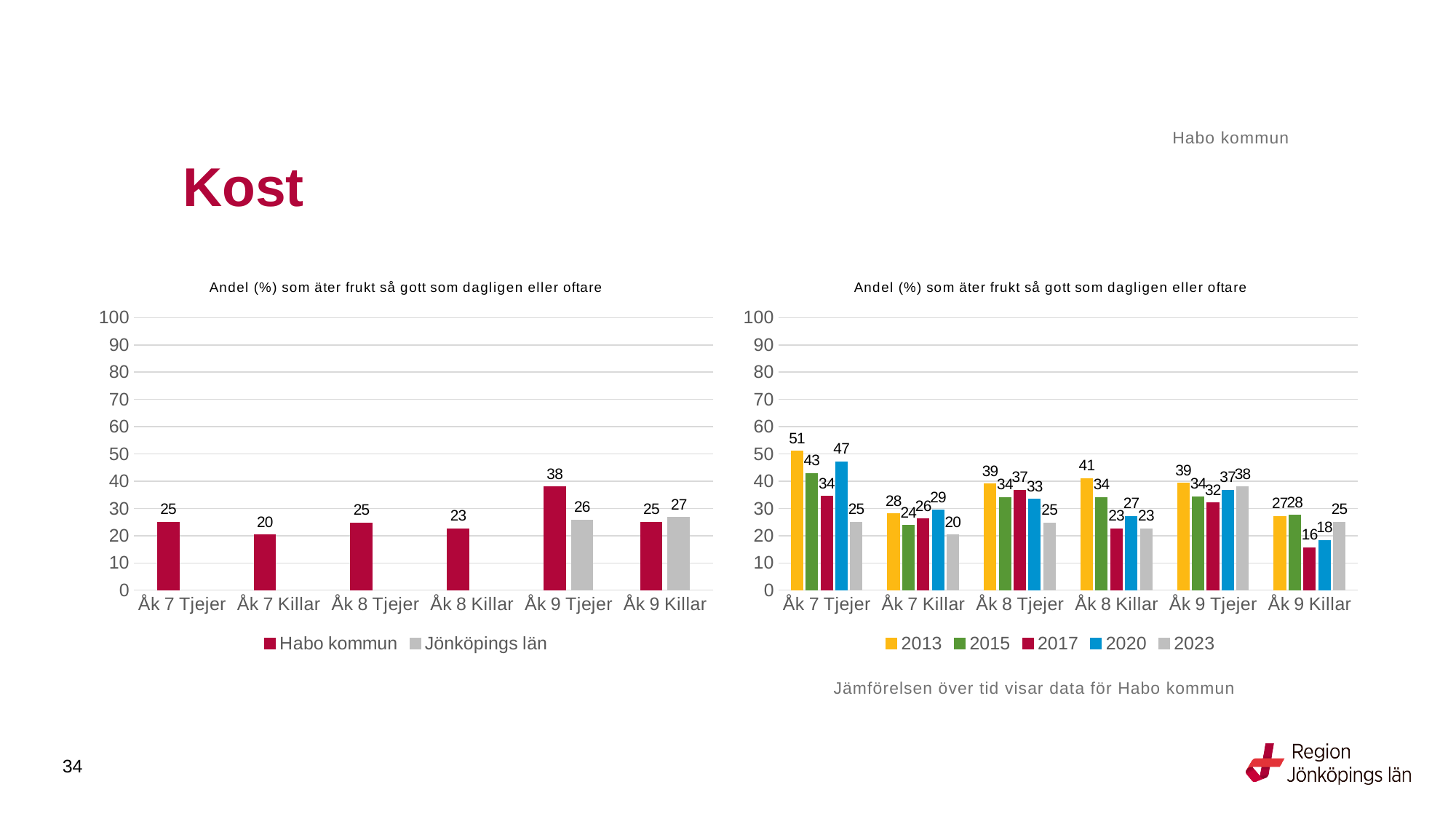
What kind of chart is the right chart? Bar chart In the right chart, what is the difference between 2013 and 2023 for Åk 7 Tjejer? 26 In the right chart, which is larger for Åk 9 Tjejer: 2013 or 2023? 2013 In the left chart, which category has the lowest value for Habo kommun? Åk 7 Killar In the right chart, what is the value for 2013 for Åk 7 Tjejer? 51 In the left chart, what is the value for Habo kommun for Åk 9 Tjejer? 38 In the left chart, which category has the highest value for Habo kommun? Åk 9 Tjejer In the left chart, what is the difference between Jönköpings län and Habo kommun for Åk 9 Killar? 2 In the left chart, how many series does the legend list? 2 In the right chart, what is the value for 2017 for Åk 9 Killar? 16 In the right chart, which year has the highest value for Åk 8 Killar? 2013 In the right chart, how many series does the legend list? 5